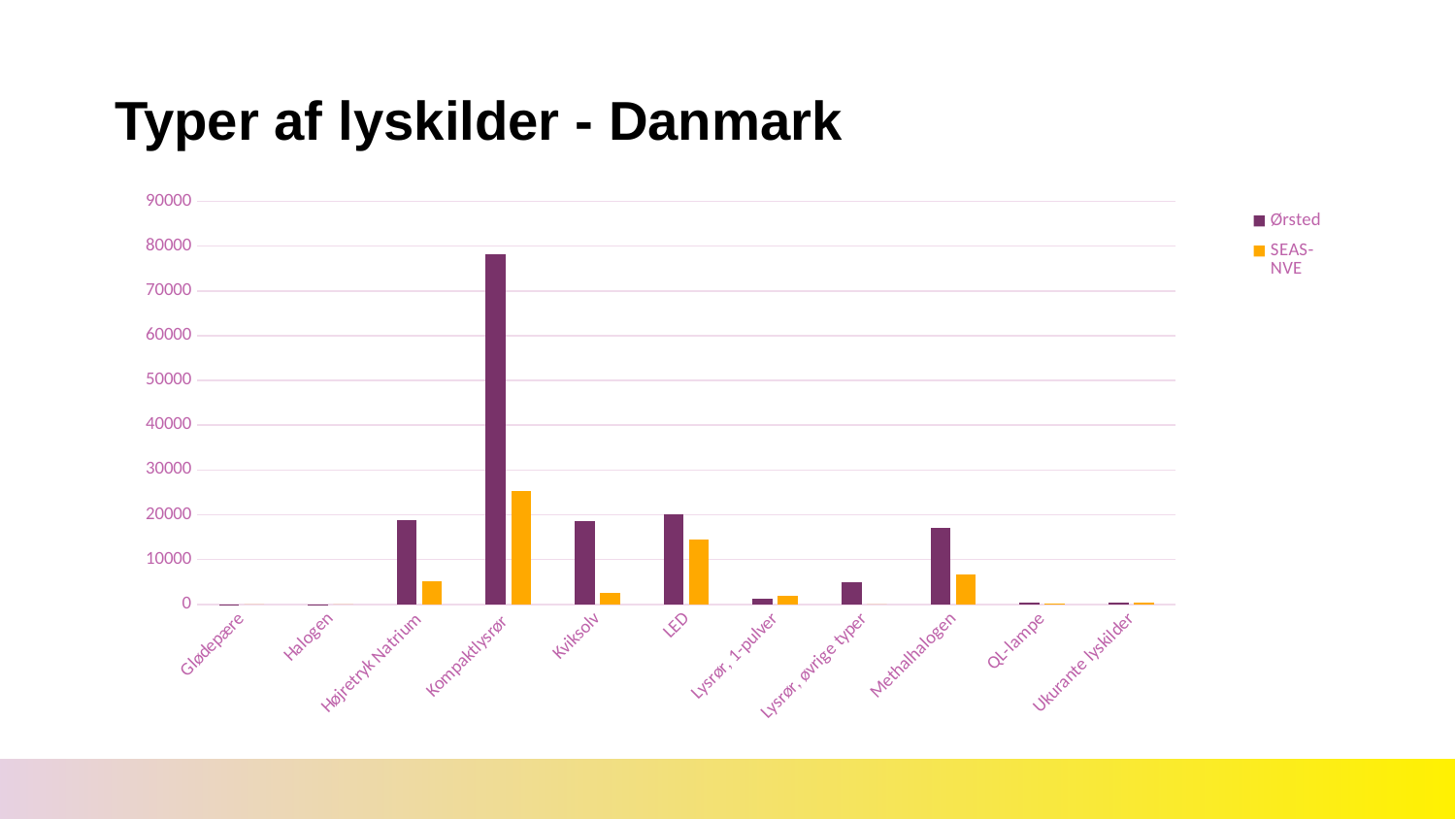
Which category has the highest value for SEAS-NVE? Kompaktlysrør How many series does the legend list? 2 What is the title of the chart? Typer af lyskilder - Danmark Is the SEAS-NVE value for Kompaktlysrør greater or less than 20000? greater Which is larger for Kviksolv, the Ørsted value or the SEAS-NVE value? Ørsted What kind of chart is shown on the slide? bar chart Is the SEAS-NVE value for Højretryk Natrium greater or less than 10000? less How many categories are shown on the x axis? 11 Which is larger for LED, the Ørsted value or the SEAS-NVE value? Ørsted Which category has the highest value for Ørsted? Kompaktlysrør Is the Ørsted value for Kompaktlysrør greater or less than 70000? greater